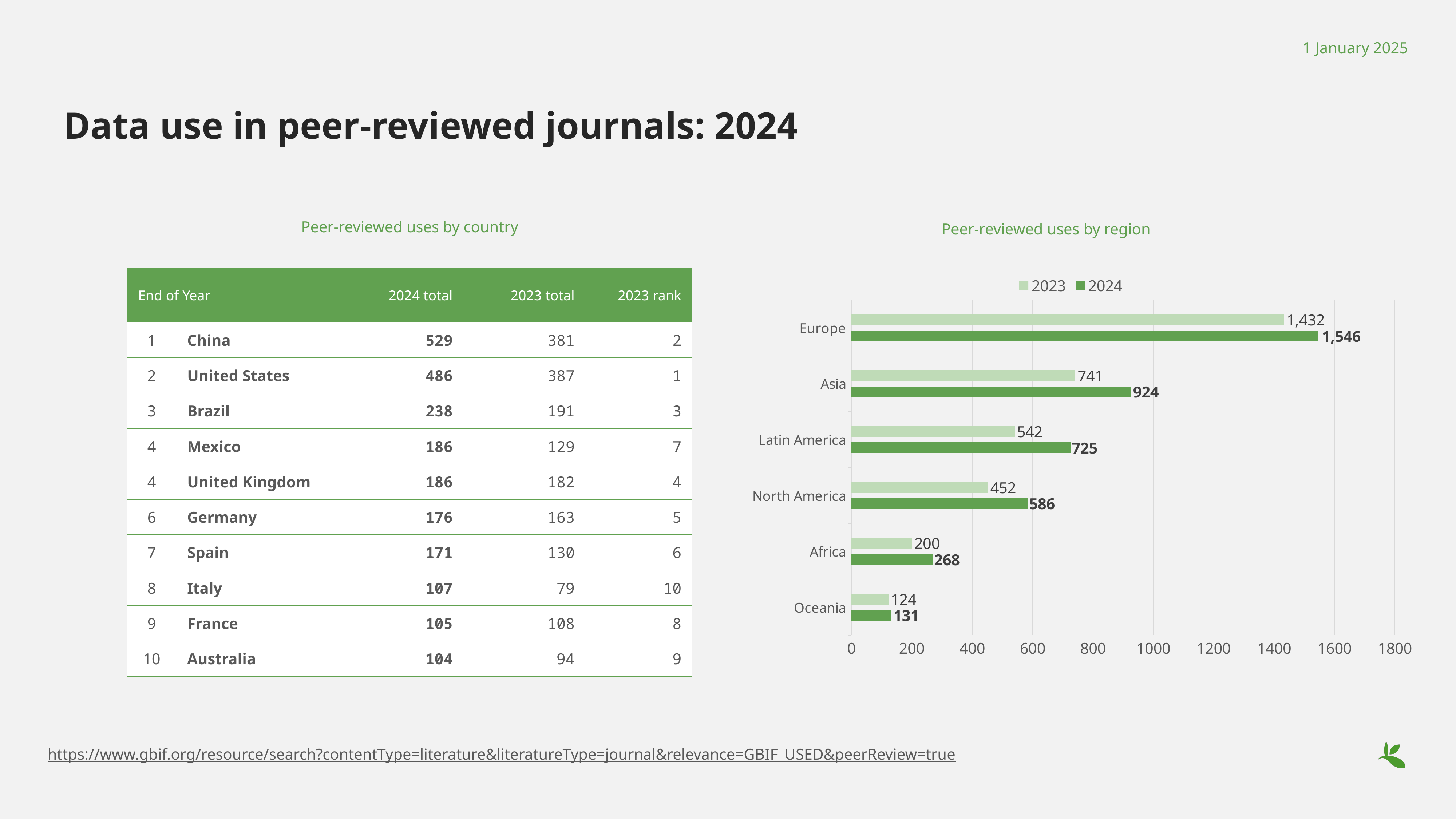
In the 'Peer-reviewed uses by region' chart, what is the 2023 value for Oceania? 124 In the 'Peer-reviewed uses by region' chart, what is the 2023 value for Asia? 741 What kind of chart is 'Peer-reviewed uses by region'? Bar chart In the 'Peer-reviewed uses by region' chart, which region has the lowest 2023 value? Oceania In the 'Peer-reviewed uses by region' chart, what is the difference between the 2024 and 2023 values for North America? 134 In the 'Peer-reviewed uses by region' chart, which is larger: the 2024 value for Africa or the 2023 value for North America? 2023 value for North America How many regions are shown in the 'Peer-reviewed uses by region' chart? 6 In the 'Peer-reviewed uses by region' chart, what is the 2024 value for Europe? 1,546 In the 'Peer-reviewed uses by region' chart, what is the 2024 value for Latin America? 725 In the 'Peer-reviewed uses by region' chart, which region has the highest 2024 value? Europe How many series does the legend of the 'Peer-reviewed uses by region' chart list? 2 In the 'Peer-reviewed uses by region' chart, is the 2024 value for Asia greater or less than 800? greater